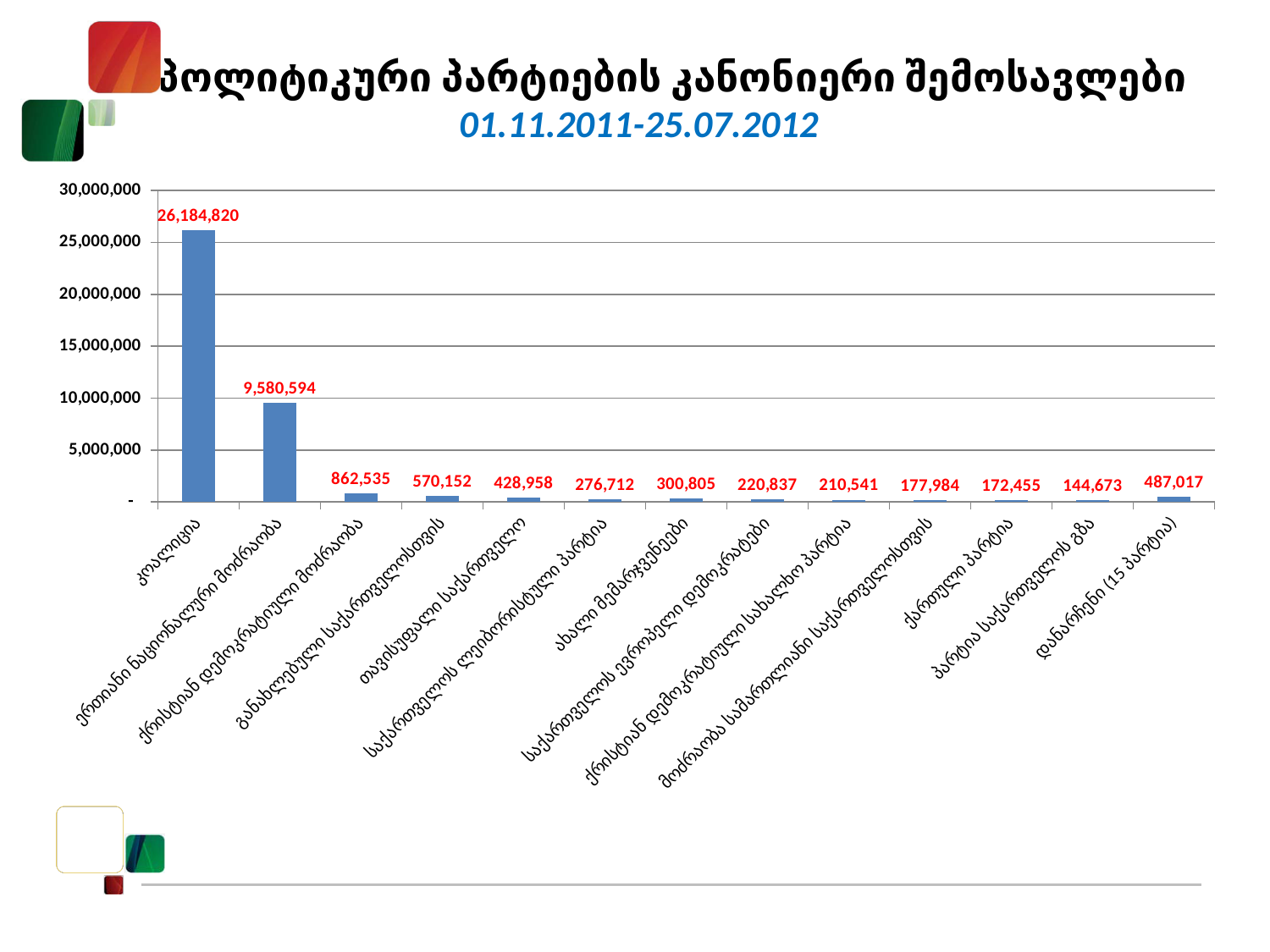
What is the value for კოალიცია? 26,184,820 What is the value for დანარჩენი (15 პარტია)? 487,017 Which category has the lowest value? პარტია საქართველოს გზა How many categories are shown on the x axis? 13 Is the value for ერთიანი ნაციონალური მოძრაობა greater or less than 10,000,000? less What is the difference between the values for კოალიცია and ერთიანი ნაციონალური მოძრაობა? 16,604,226 What date range is given in the subtitle of the chart? 01.11.2011-25.07.2012 What is the value for ერთიანი ნაციონალური მოძრაობა? 9,580,594 Which is larger, the value for ახალი მემარჯვენეები or the value for საქართველოს ლეიბორისტული პარტია? ახალი მემარჯვენეები What kind of chart is shown on the slide? bar chart What is the value for ქართული პარტია? 172,455 Which category has the highest value? კოალიცია